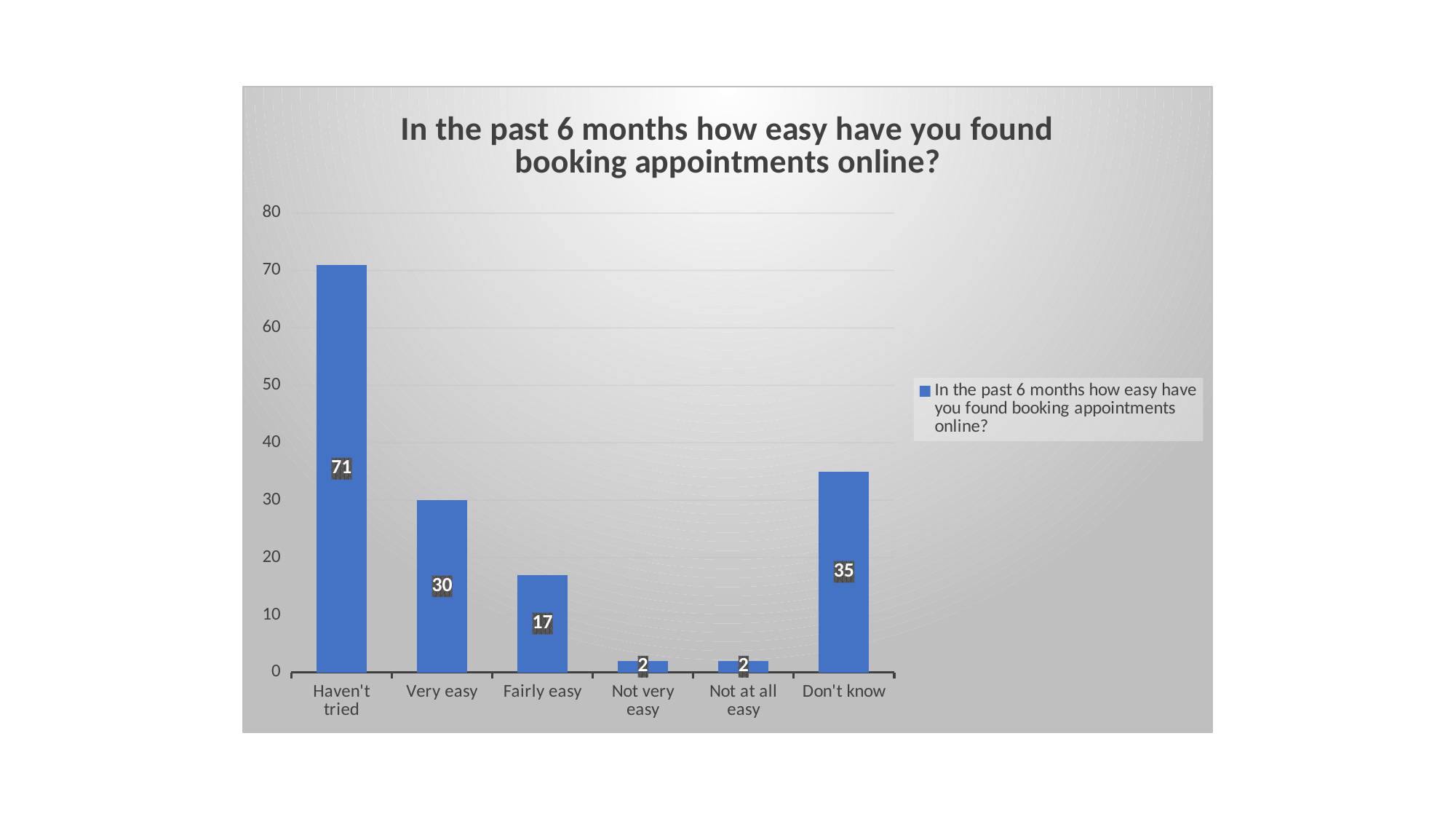
What is the value for "Fairly easy"? 17 How many categories are shown on the x axis? 6 Which category has the highest value? Haven't tried Is the value for "Haven't tried" greater or less than 60? greater What is the difference between the values for "Haven't tried" and "Don't know"? 36 What is the value for "Very easy"? 30 What is the value for "Haven't tried"? 71 What kind of chart is shown on the slide? Bar chart What is the difference between the values for "Very easy" and "Fairly easy"? 13 Which is larger, the value for "Very easy" or the value for "Don't know"? Don't know What is the value for "Don't know"? 35 What is the title of the chart? In the past 6 months how easy have you found booking appointments online?